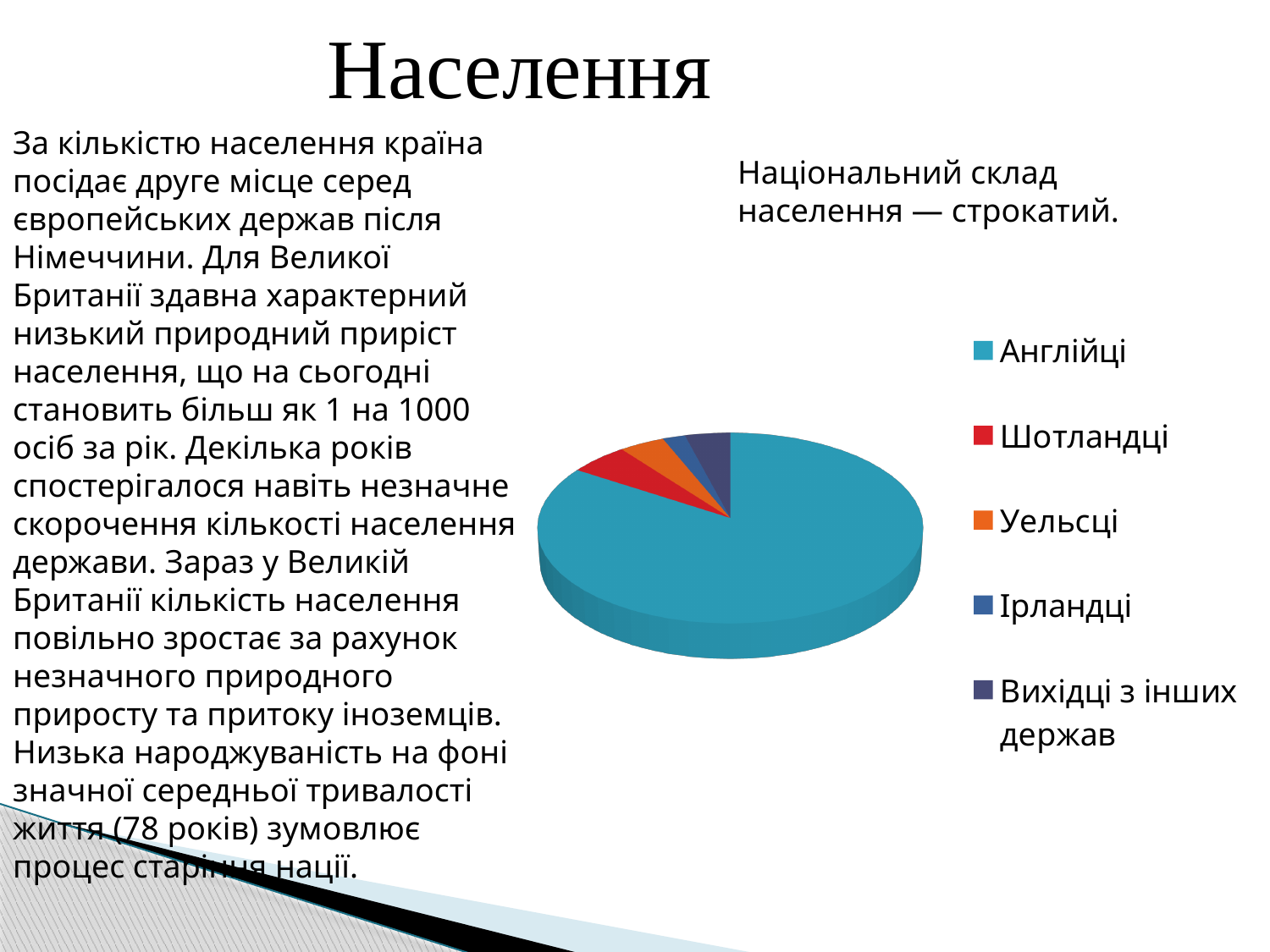
Which slice is larger in the pie chart, Англійці or Шотландці? Англійці How many categories does the pie chart's legend list? 5 Does the Англійці slice take up more or less than half of the pie chart? more Which slice is larger in the pie chart, Англійці or Уельсці? Англійці Which slice is larger in the pie chart, Англійці or Ірландці? Англійці What kind of chart is shown on the slide? pie chart What is the last entry listed in the pie chart's legend? Вихідці з інших держав Which category has the largest slice in the pie chart? Англійці What colour is the Англійці slice in the pie chart? blue